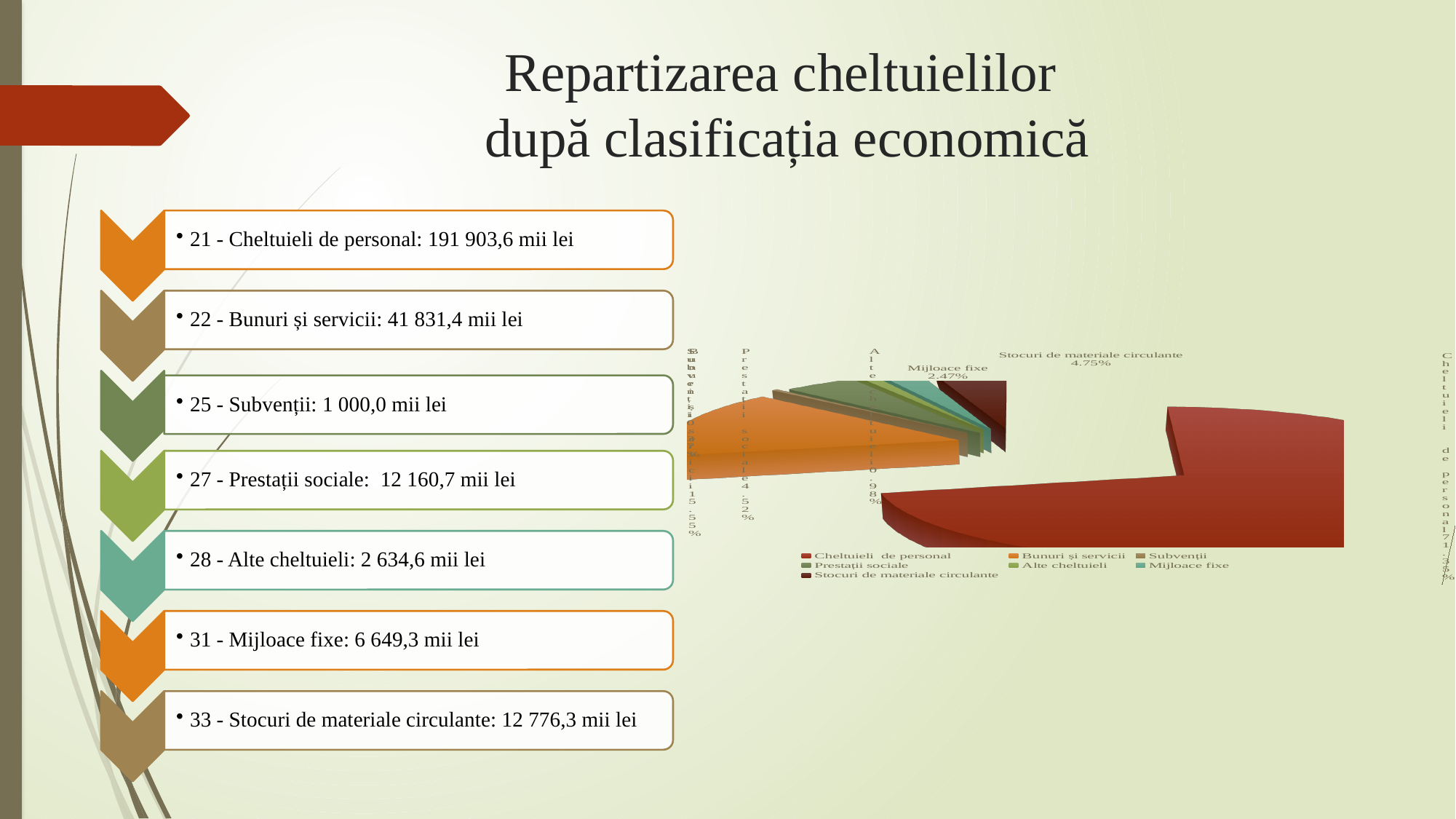
What is the difference in percentage points between Stocuri de materiale circulante (4.75%) and Mijloace fixe (2.47%) in the pie chart? 2.28% Which slice is larger in the pie chart, Mijloace fixe or Alte cheltuieli? Mijloace fixe How many entries does the chart legend list? 7 What percentage is shown for Stocuri de materiale circulante in the pie chart? 4.75% Which category has the largest slice in the pie chart? Cheltuieli de personal What colour is the Cheltuieli de personal slice in the pie chart? red What kind of chart is shown on the slide? pie chart What percentage is shown for Mijloace fixe in the pie chart? 2.47% Which slice is larger in the pie chart, Stocuri de materiale circulante or Mijloace fixe? Stocuri de materiale circulante What percentage is shown for Prestații sociale in the pie chart? 4.52% What percentage is shown for Alte cheltuieli in the pie chart? 0.98% How many slices does the pie chart have? 7